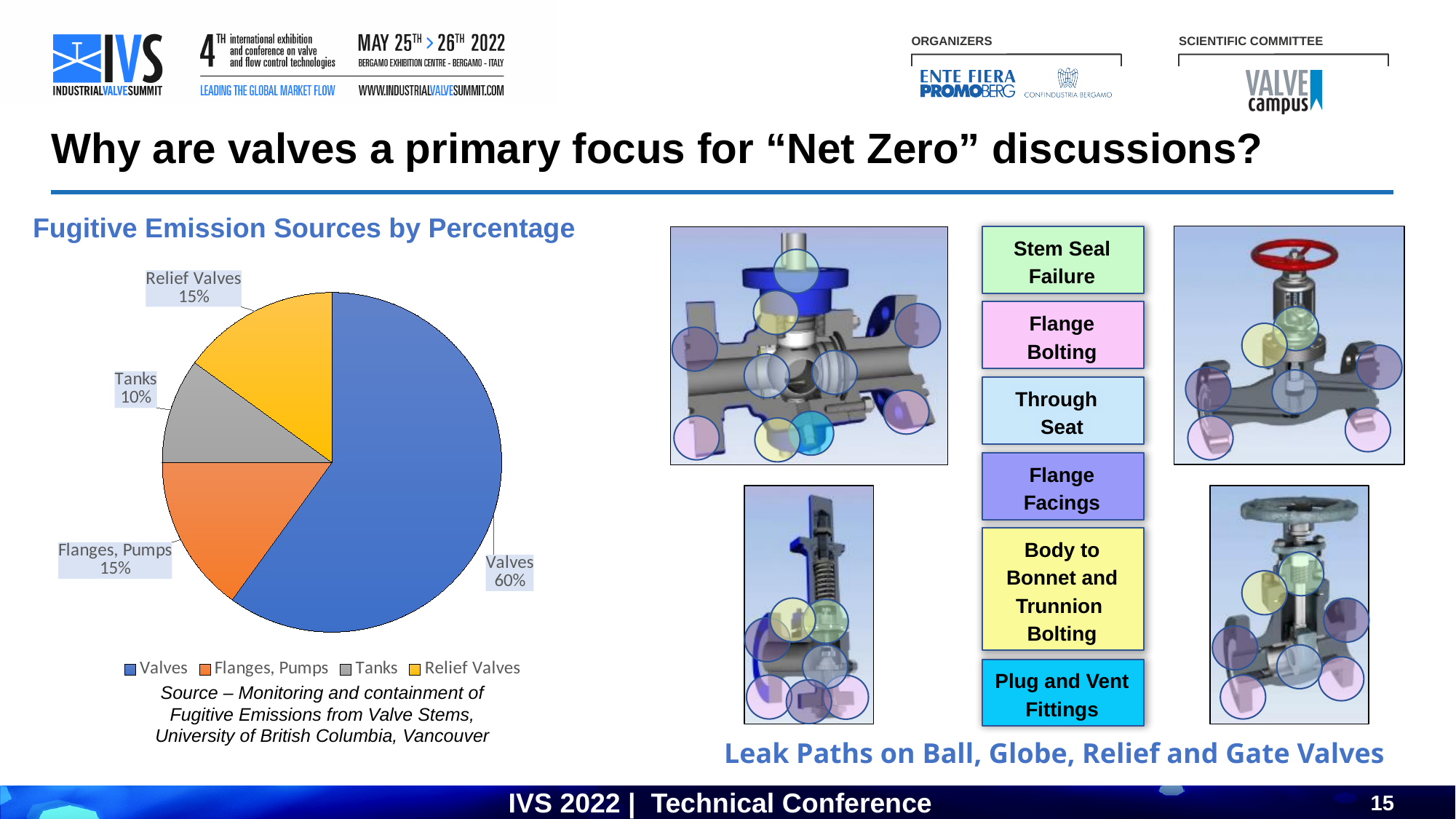
What type of chart is used to show Fugitive Emission Sources by Percentage? Pie chart What is the title of the chart on the left of the slide? Fugitive Emission Sources by Percentage Which has a larger share of fugitive emission sources, Relief Valves or Tanks? Relief Valves How many categories are shown in the Fugitive Emission Sources by Percentage pie chart? 4 Which category has the largest share in the Fugitive Emission Sources by Percentage pie chart? Valves What percentage of fugitive emission sources is attributed to Relief Valves? 15% What percentage of fugitive emission sources is attributed to Tanks? 10% What is the difference in percentage points between Valves and Tanks in the pie chart? 50 What colour is the Valves slice in the pie chart? Blue What percentage of fugitive emission sources is attributed to Valves in the pie chart? 60% What percentage of fugitive emission sources is attributed to Flanges, Pumps? 15% Which category has the smallest share in the Fugitive Emission Sources by Percentage pie chart? Tanks